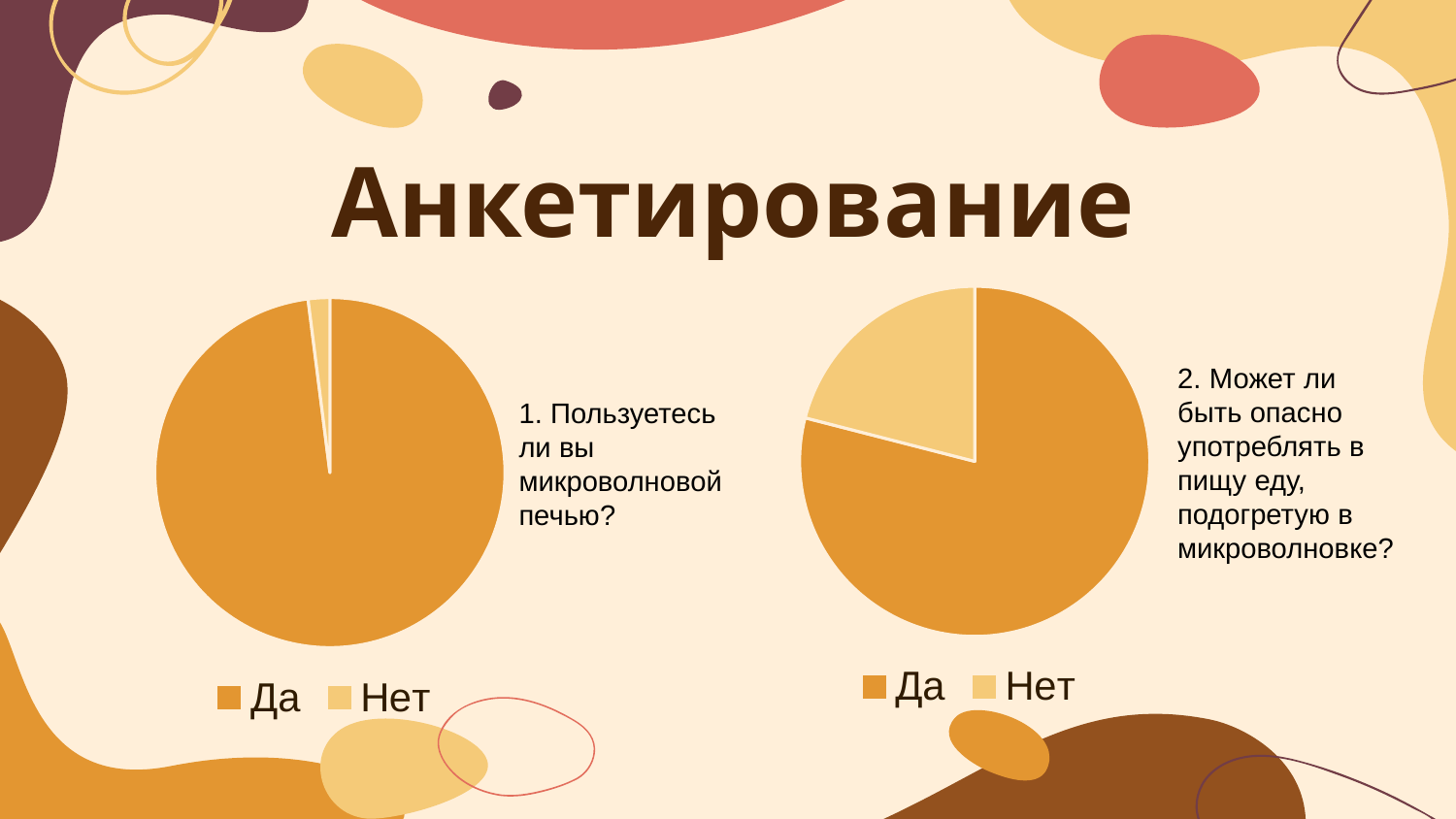
What kind of chart is the left chart on the slide (next to question 1 about using a microwave oven)? pie chart How many entries does the legend of the left pie chart list? 2 In the right pie chart, which answer has the largest slice? Да What are the two legend entries shown under the right pie chart? Да, Нет In the left pie chart, which slice is larger: Да or Нет? Да In the left pie chart, which answer has the smallest slice? Нет What kind of chart is the right chart on the slide (next to question 2 about whether microwaved food may be dangerous)? pie chart In the left pie chart, which answer has the largest slice? Да Which chart has the larger Нет slice: the left pie chart or the right pie chart? the right pie chart In the right pie chart, which slice is larger: Да or Нет? Да In the right pie chart, which answer has the smallest slice? Нет How many slices does the right pie chart have? 2